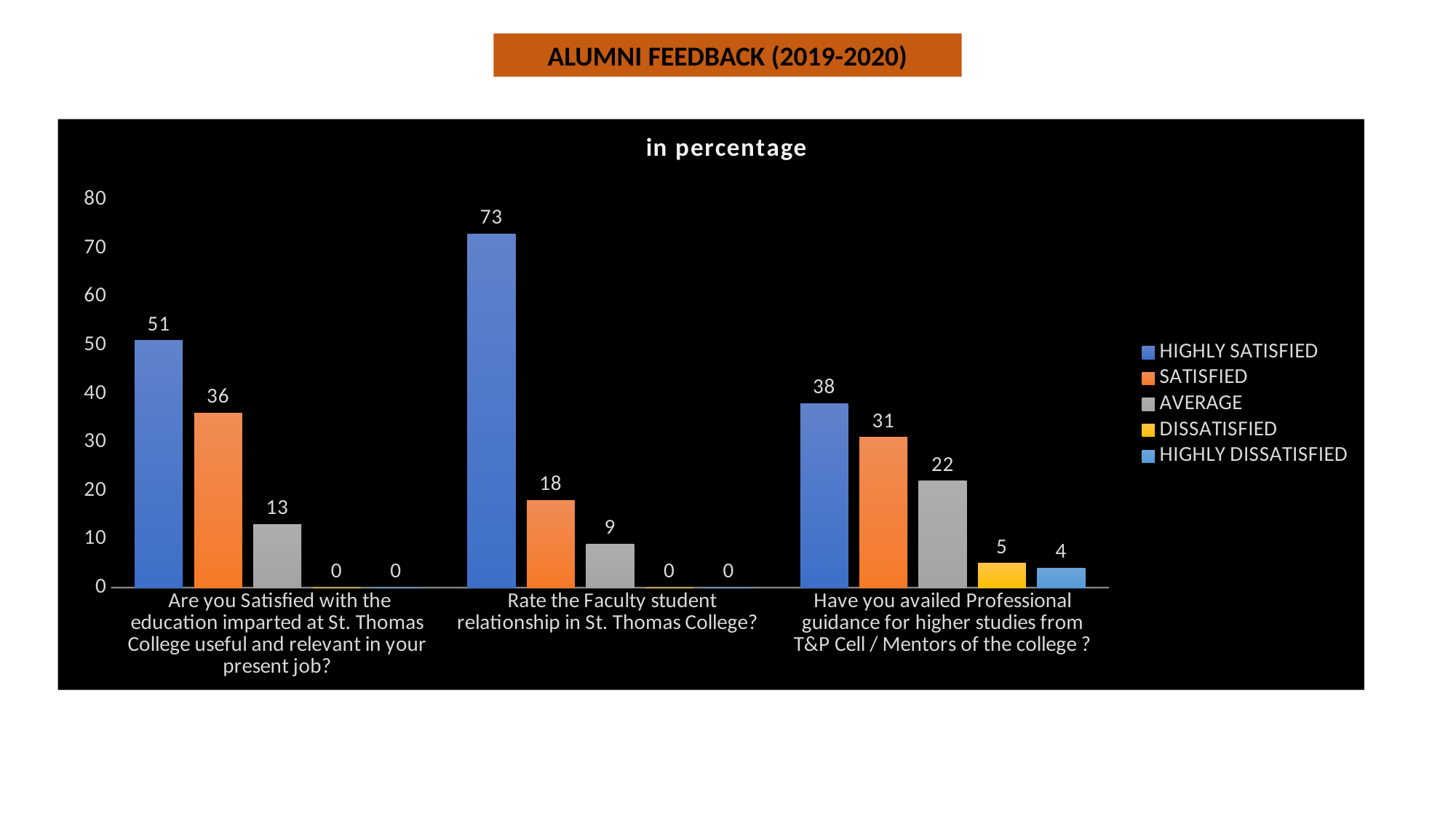
Which question has the highest HIGHLY SATISFIED value? Rate the Faculty student relationship in St. Thomas College? What is the DISSATISFIED value for the question about availing Professional guidance for higher studies? 5 What is the SATISFIED value for the question about education being useful and relevant in your present job? 36 What is the HIGHLY SATISFIED value for the question "Rate the Faculty student relationship in St. Thomas College?"? 73 What kind of chart is shown on the slide? Bar chart How many series does the legend list? 5 What is the title of the chart? in percentage Which is larger: the AVERAGE value for the education relevance question or the AVERAGE value for the Faculty student relationship question? Education relevance question (13) Which question has the lowest SATISFIED value? Rate the Faculty student relationship in St. Thomas College? How many question categories are shown on the x axis? 3 What is the difference between the HIGHLY SATISFIED values for the Faculty student relationship question and the Professional guidance question? 35 What is the AVERAGE value for the question about availing Professional guidance for higher studies from T&P Cell / Mentors? 22